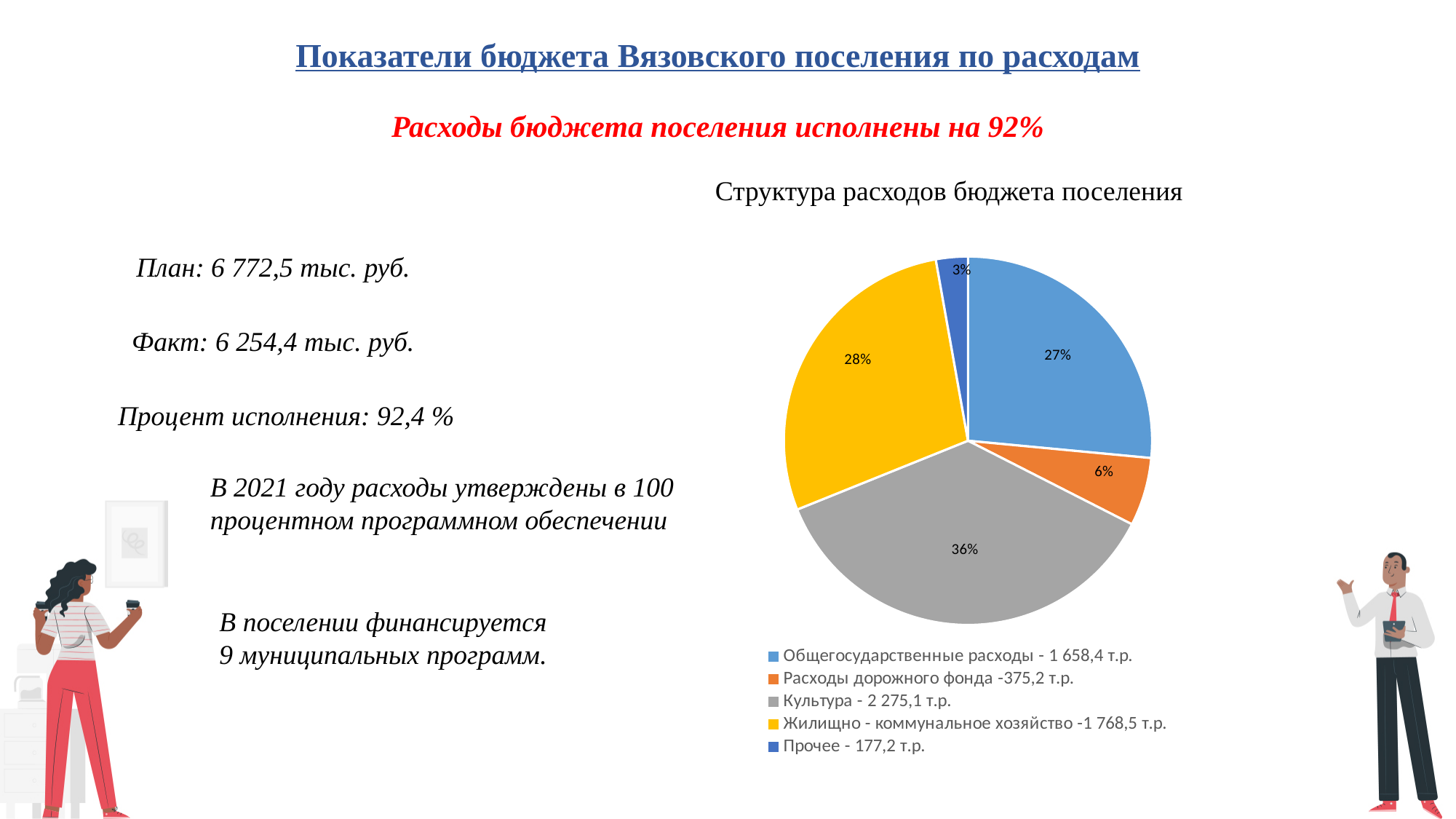
What is the title of the chart? Структура расходов бюджета поселения How many slices does the pie chart have? 5 What share of the pie does Общегосударственные расходы take? 27% What share of the pie does Культура take? 36% What kind of chart is shown on the slide? pie chart What share of the pie does Жилищно - коммунальное хозяйство take? 28% Which category has the smallest slice of the pie? Прочее Which category has the largest slice of the pie? Культура What amount is listed in the legend for Культура? 2 275,1 т.р. What amount is listed in the legend for Прочее? 177,2 т.р. Which slice is larger: Общегосударственные расходы or Расходы дорожного фонда? Общегосударственные расходы